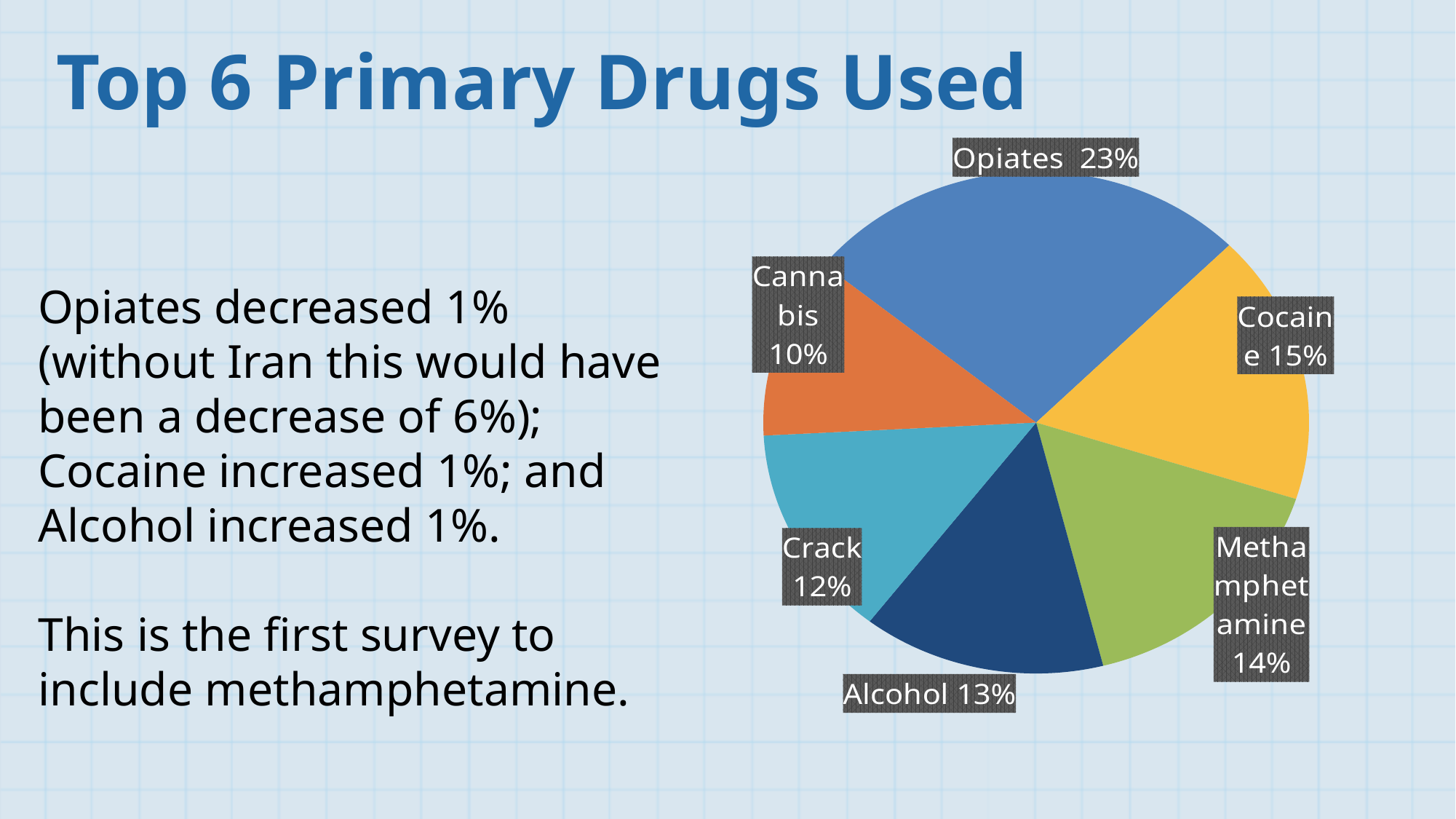
How many drug categories are shown in the pie chart? 6 Which drug has the largest share of the pie? Opiates What is the difference between the Opiates share and the Cocaine share? 8% What percentage is shown for Cocaine? 15% What kind of chart is shown on the slide? Pie chart What percentage is shown for Methamphetamine? 14% What colour is the Alcohol slice? Dark blue What percentage is shown for Opiates? 23% What percentage is shown for Crack? 12% What is the title of the slide containing the pie chart? Top 6 Primary Drugs Used Which drug has the smallest share of the pie? Cannabis Which has a larger share, Alcohol or Crack? Alcohol